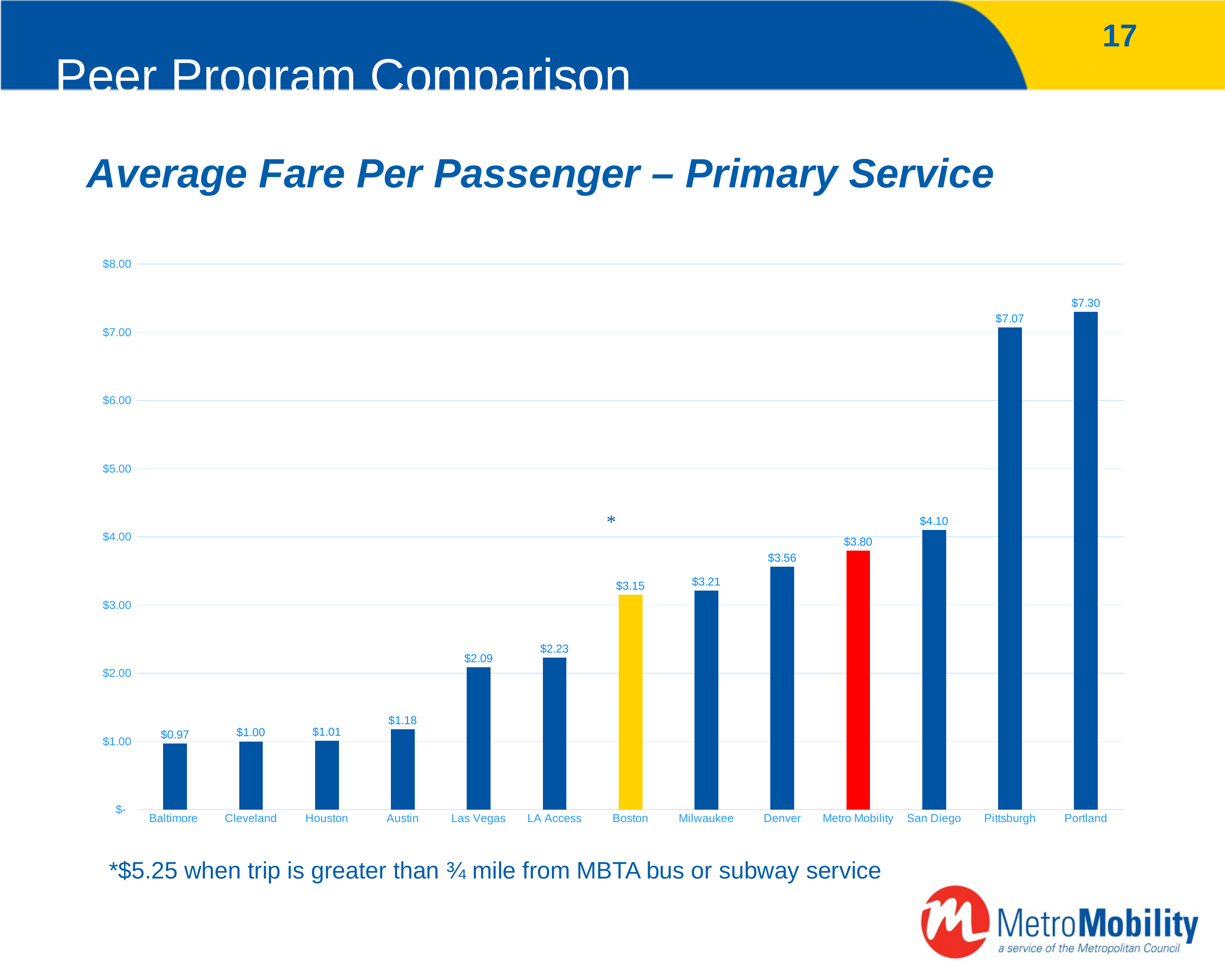
How many cities or programs are shown in the chart? 13 Which has a higher average fare per passenger, San Diego or Milwaukee? San Diego Which city has the highest average fare per passenger? Portland What is the average fare per passenger for Boston? $3.15 What is the average fare per passenger for Metro Mobility? $3.80 What kind of chart is shown on the slide? Bar chart Which city has the lowest average fare per passenger? Baltimore Is the value for LA Access greater or less than $3.00? less What is the difference between the average fares of Portland and Pittsburgh? $0.23 Which bar in the chart is coloured red? Metro Mobility What is the difference between the average fares of Metro Mobility and Denver? $0.24 What is the average fare per passenger for Las Vegas? $2.09